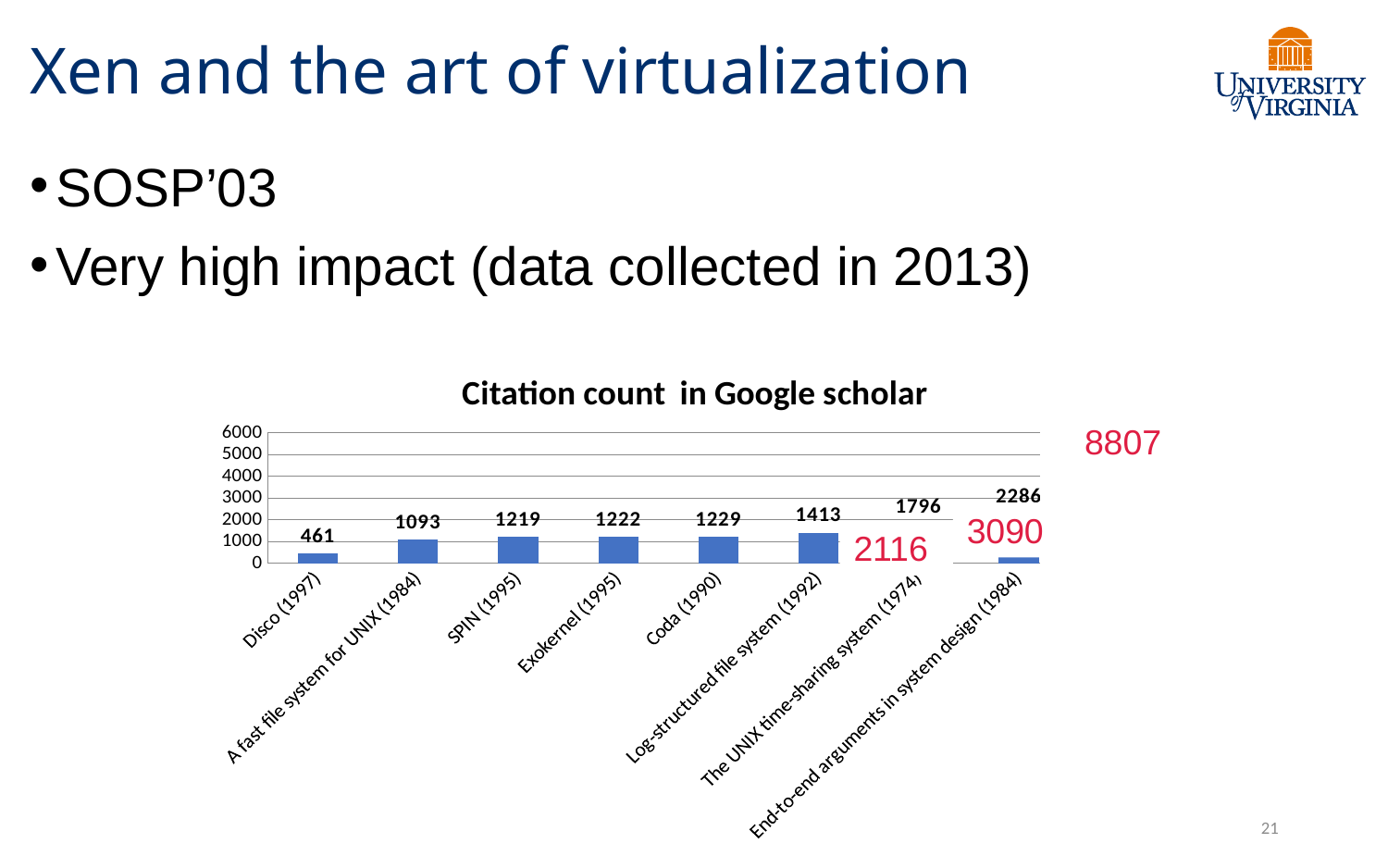
Which paper has the lowest citation count in the chart? Disco (1997) What is the citation count for Coda (1990)? 1229 Is the citation count for Exokernel (1995) greater or less than 1000? greater What is the citation count for Disco (1997)? 461 What is the title of the chart? Citation count in Google scholar What is the difference in citation count between A fast file system for UNIX (1984) and Disco (1997)? 632 What is the citation count for Log-structured file system (1992)? 1413 What is the citation count for The UNIX time-sharing system (1974)? 1796 Which has more citations, Log-structured file system (1992) or SPIN (1995)? Log-structured file system (1992) What type of chart is used to show the citation counts? bar chart